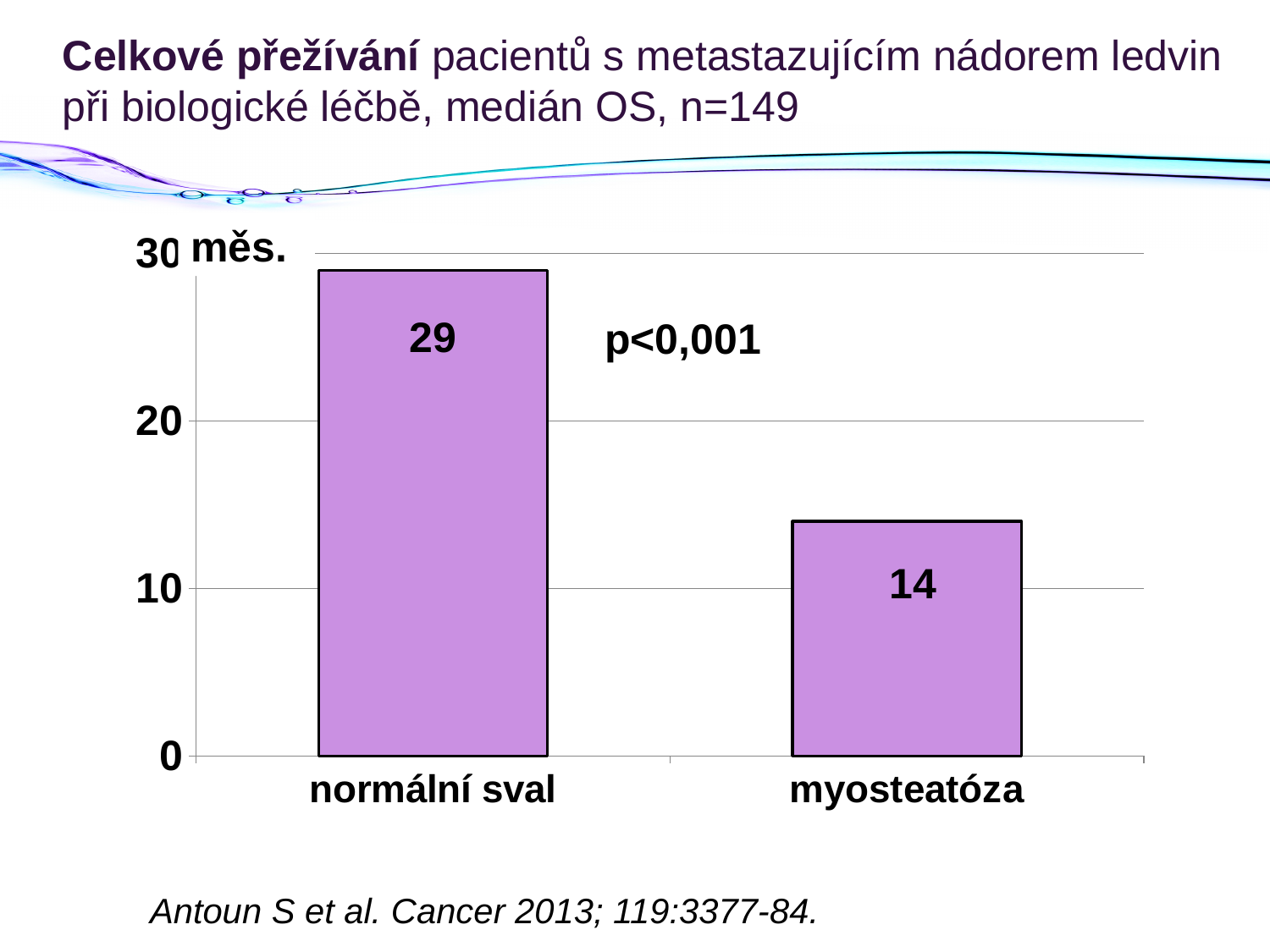
Is the value for normální sval larger or smaller than the value for myosteatóza? larger What p-value is printed on the chart? p<0,001 What is the median overall survival value shown for myosteatóza? 14 What unit label is shown at the top of the y axis? měs. Which category has the higher bar? normální sval Which category has the lower bar? myosteatóza What is the difference between the values for normální sval and myosteatóza? 15 Is the value for normální sval greater or less than 20? greater What kind of chart is shown on the slide? bar chart What is the median overall survival value shown for normální sval? 29 How many categories are shown on the x axis? 2 Is the value for myosteatóza greater or less than 20? less